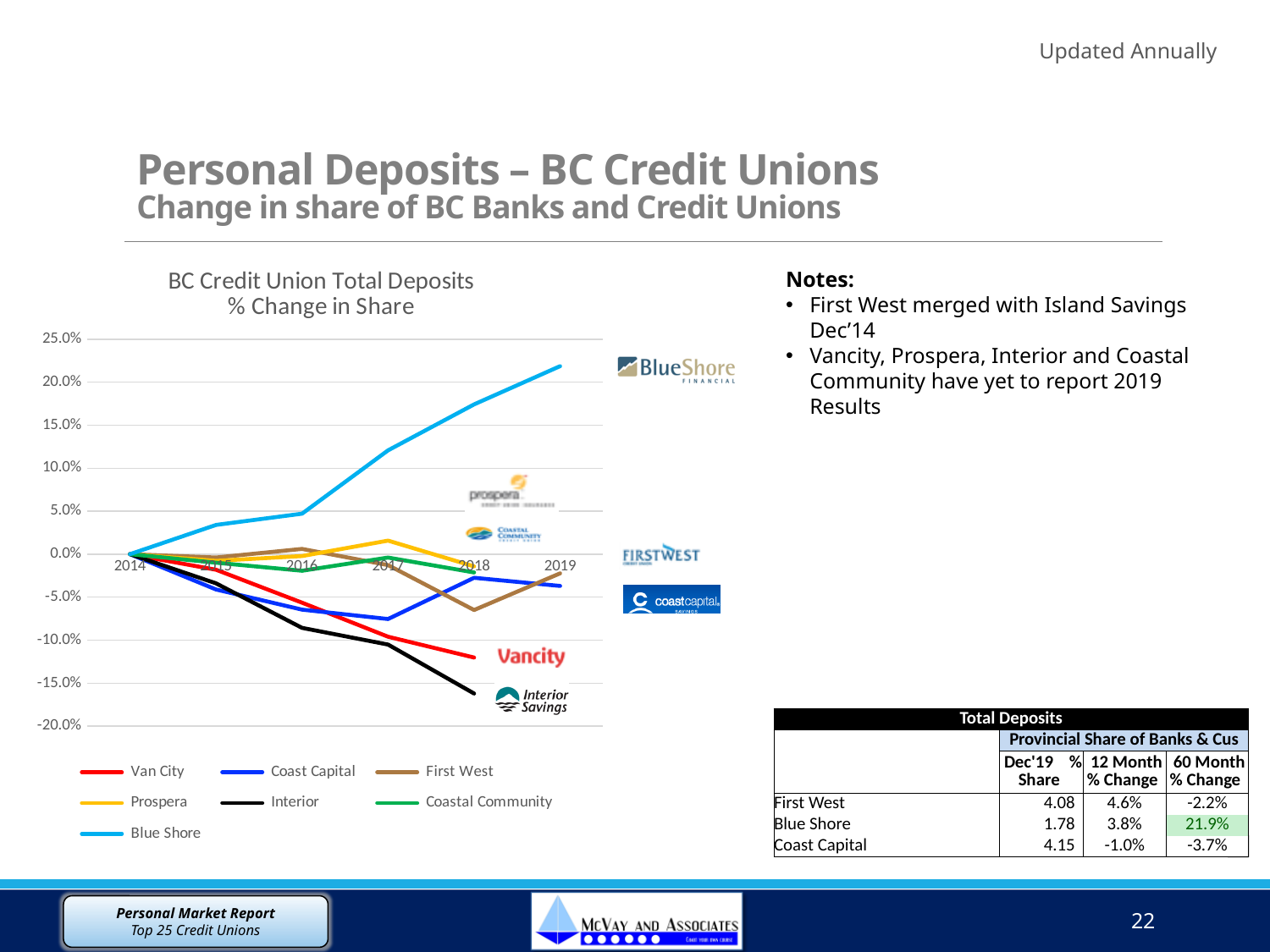
Is the value for Blue Shore in 2017 greater or less than 10.0%? greater Which series has the lowest % change in share in 2018? Interior How many series does the legend of the chart list? 7 How many years are shown along the x axis of the chart? 6 Is the value for Blue Shore in 2019 greater or less than 20.0%? greater Which series has the highest % change in share in 2019? Blue Shore Does the Blue Shore line rise or fall from 2014 to 2019? rises What kind of chart is shown on the slide? line chart What is the title of the chart? BC Credit Union Total Deposits % Change in Share Is the value for Interior in 2018 greater or less than -15.0%? less Does the Interior line rise or fall from 2014 to 2018? falls